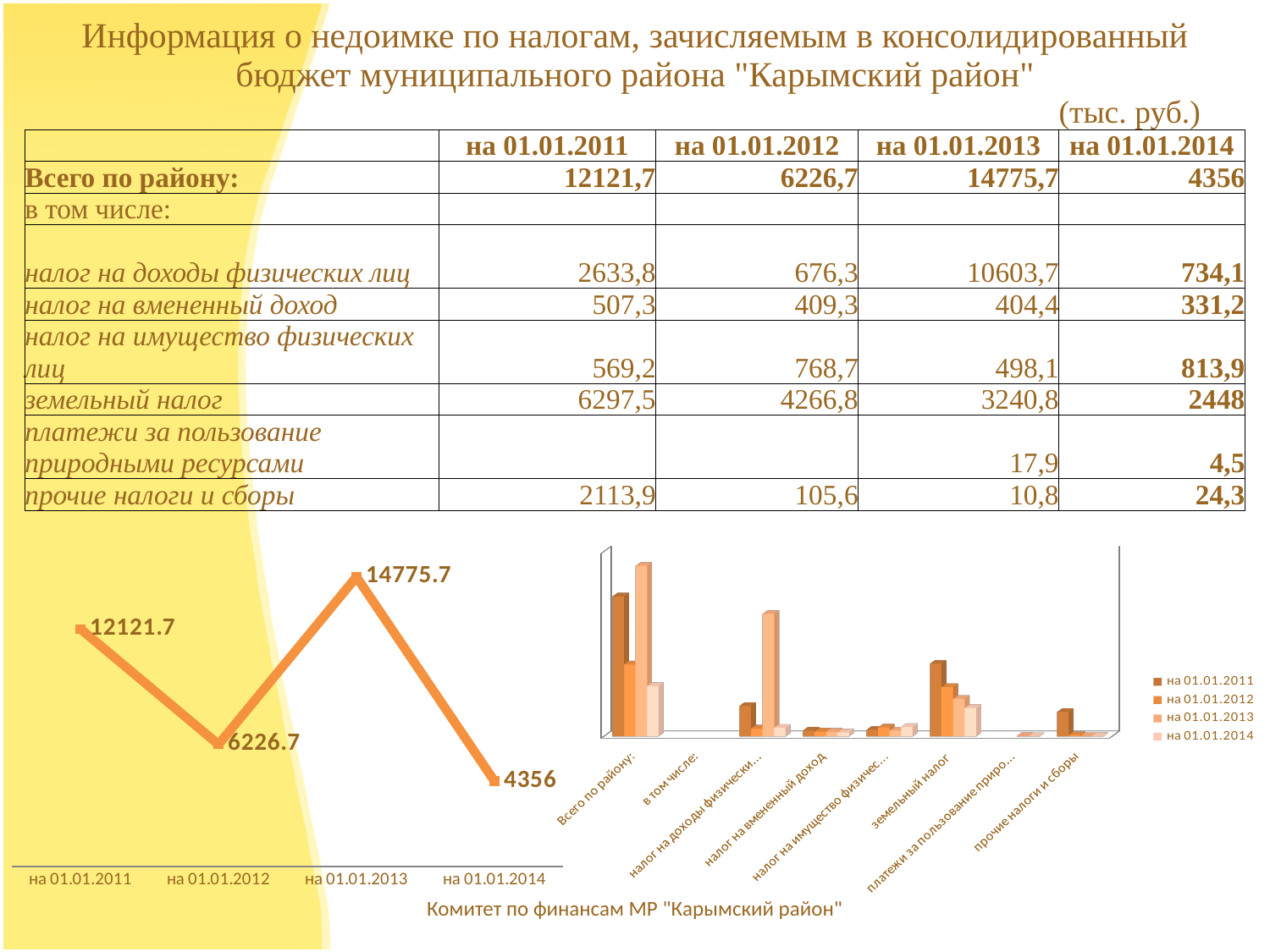
In the line chart on the left, which is larger: the value for на 01.01.2011 or the value for на 01.01.2012? на 01.01.2011 In the line chart on the left, what is the value for на 01.01.2014? 4356 What kind of chart is the chart on the right of the slide? bar chart In the line chart on the left, which date has the lowest value? на 01.01.2014 In the line chart on the left, what is the value for на 01.01.2013? 14775.7 In the line chart on the left, what is the difference between the values for на 01.01.2013 and на 01.01.2011? 2654 In the line chart on the left, what is the value for на 01.01.2011? 12121.7 How many series does the legend of the bar chart on the right list? 4 In the line chart on the left, which date has the highest value? на 01.01.2013 How many data points are plotted in the line chart on the left? 4 In the line chart on the left, does the value rise or fall from на 01.01.2013 to на 01.01.2014? fall In the line chart on the left, what is the difference between the values for на 01.01.2012 and на 01.01.2014? 1870.7